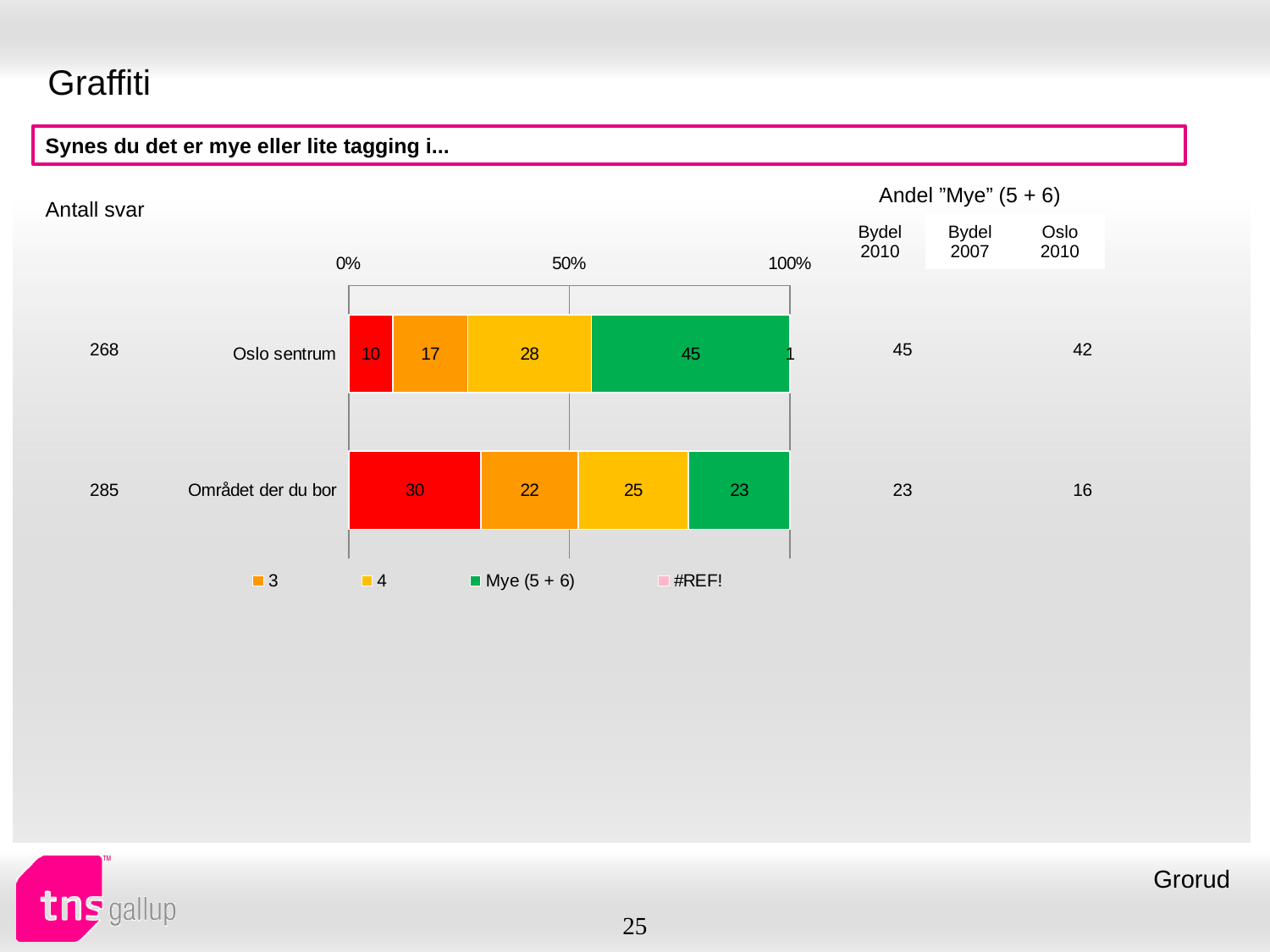
What is the difference between the "Mye (5 + 6)" values for Oslo sentrum and Området der du bor? 22 What is the value of the "3" segment for Området der du bor? 22 What kind of chart is shown on the slide? stacked bar chart What is the difference between the "3" segment values for Området der du bor and Oslo sentrum? 5 How many categories (bars) does the chart show? 2 What is the title of the question shown above the chart? Synes du det er mye eller lite tagging i... What is the value of the "4" segment for Oslo sentrum? 28 How many series does the chart legend list? 4 What is the value of the "Mye (5 + 6)" segment for Området der du bor? 23 Which category has the larger "Mye (5 + 6)" value, Oslo sentrum or Området der du bor? Oslo sentrum What is the value of the "Mye (5 + 6)" segment for Oslo sentrum? 45 What is the number of responses (Antall svar) shown for Området der du bor? 285